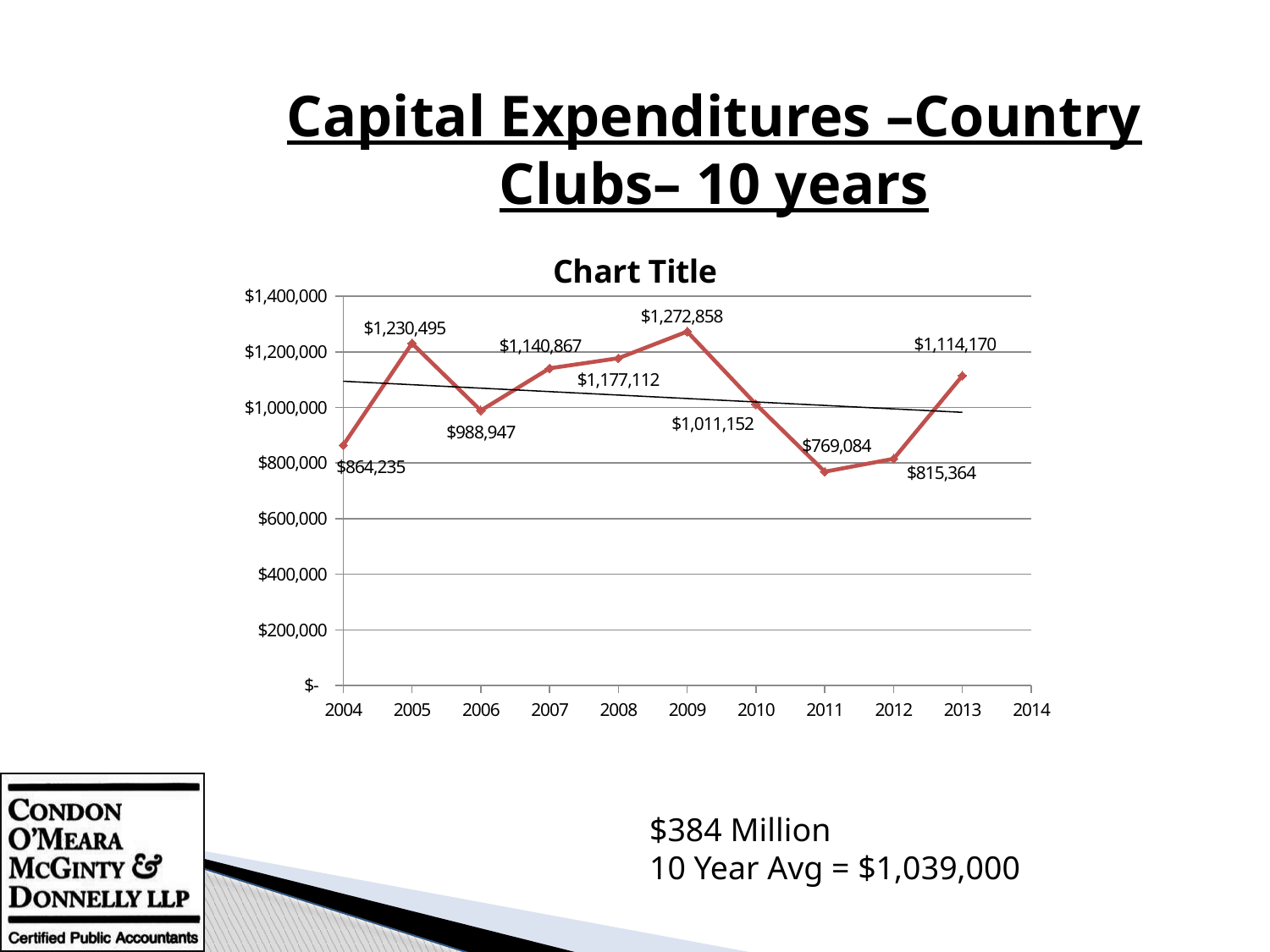
What is the capital expenditure value for 2004? $864,235 What is the capital expenditure value for 2011? $769,084 What is the difference between the 2005 value and the 2006 value? $241,548 What is the capital expenditure value for 2009? $1,272,858 How many years have data points plotted on the line? 10 Which year has the lowest capital expenditure value? 2011 What is the capital expenditure value for 2013? $1,114,170 Does the value rise or fall from 2012 to 2013? rise What kind of chart is shown on the slide? line chart Which year has the highest capital expenditure value? 2009 Is the value for 2010 greater or less than $1,000,000? greater Which year has the larger value, 2007 or 2008? 2008